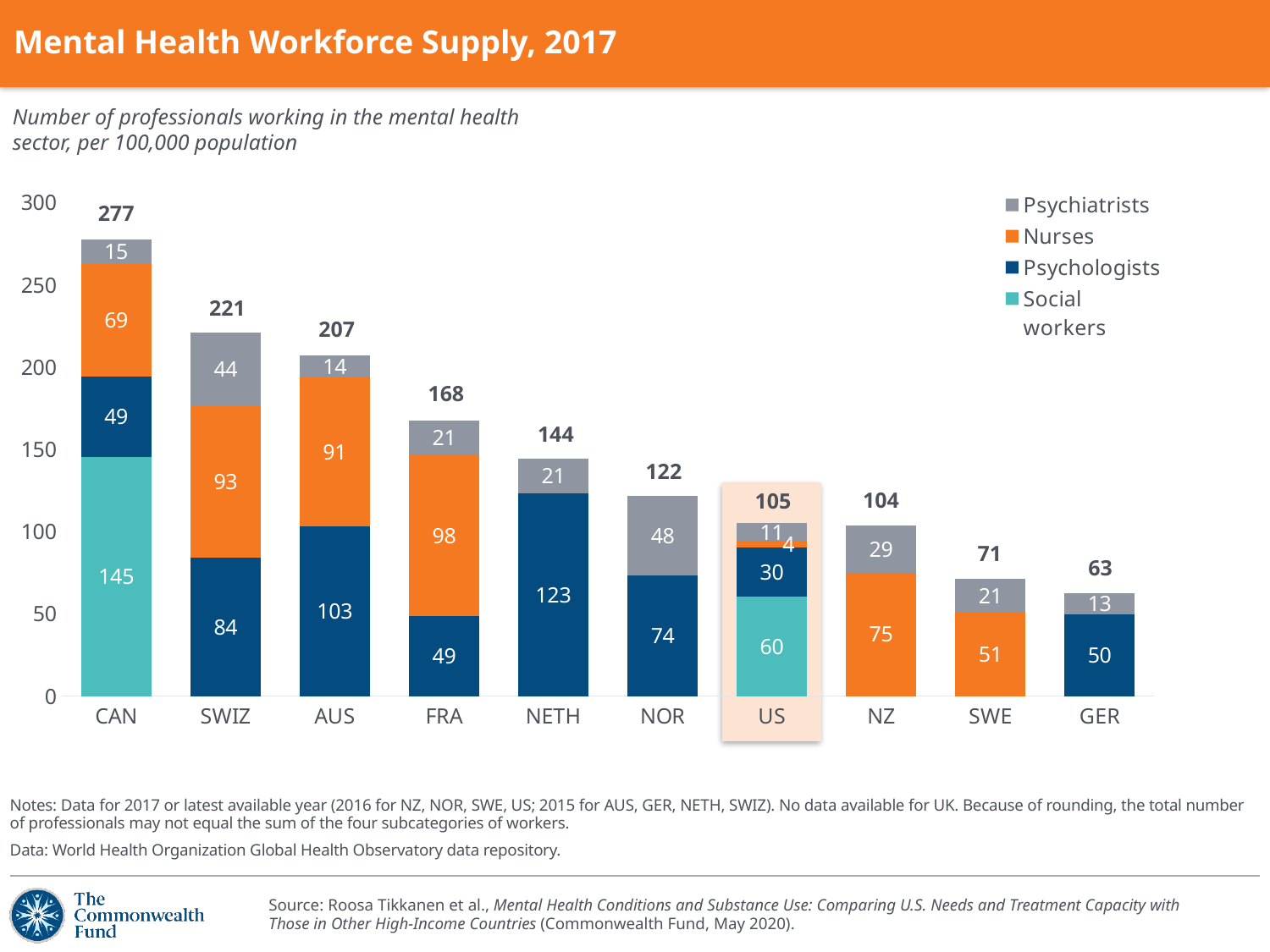
How many countries are shown on the x axis of the chart? 10 How many series does the legend list? 4 Which country has more Psychologists per 100,000 population, NETH or AUS? NETH Which country has the lowest total number of mental health professionals per 100,000 population? GER Which country's bar is highlighted with a shaded background on the chart? US What is the value for Psychiatrists in NOR? 48 Which country has the highest total number of mental health professionals per 100,000 population? CAN What is the value for Nurses in FRA? 98 What is the difference between the total for SWIZ and the total for AUS? 14 What is the value for Social workers in the US? 60 What type of chart is shown on the slide? Stacked bar chart What is the total number of professionals per 100,000 population for CAN? 277